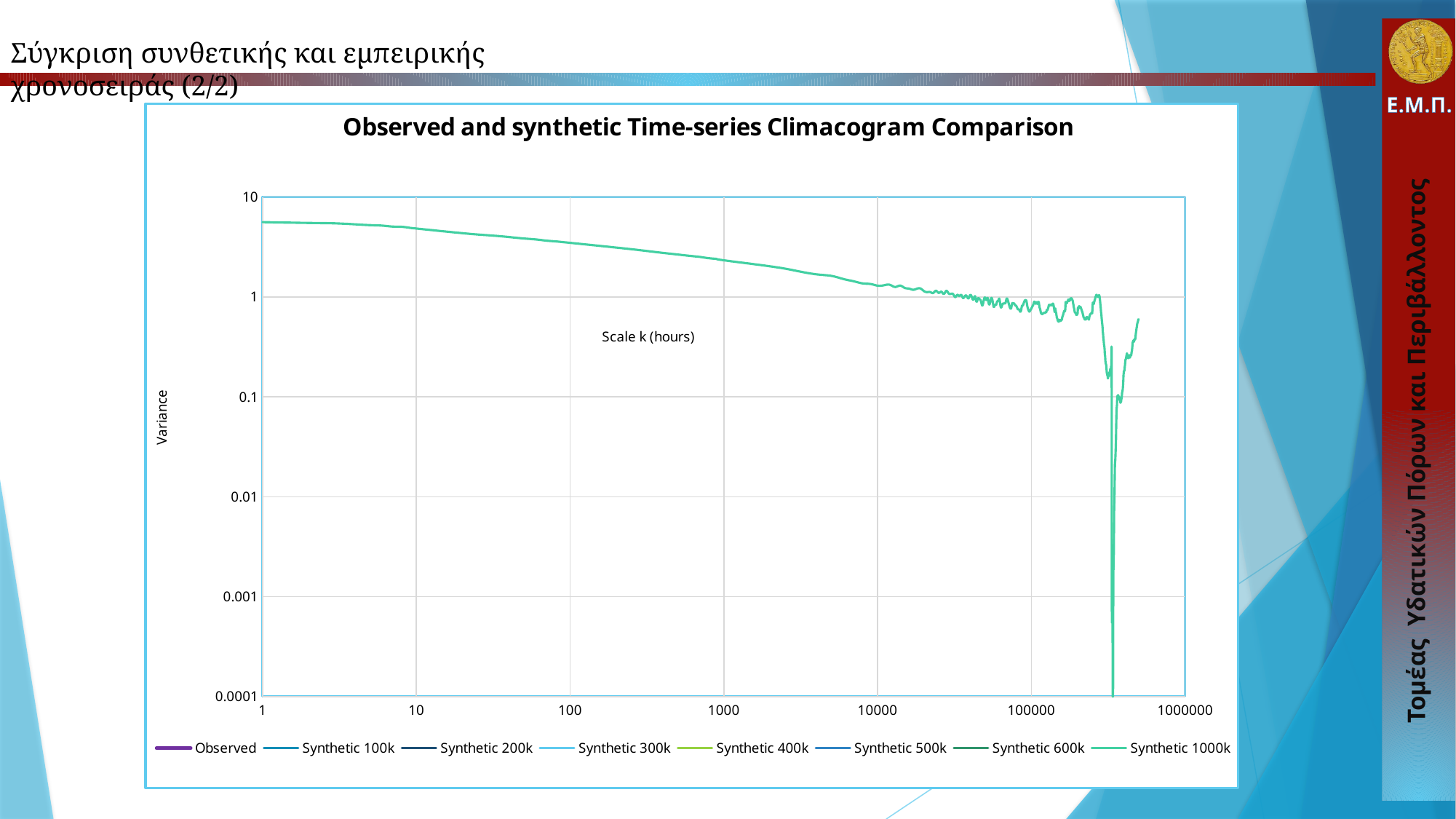
What kind of chart is shown on the slide? line chart Which is larger, the variance at scale k = 1 hour or at scale k = 1000 hours? scale k = 1 hour Is the variance at scale k = 1000 hours greater or less than 1? greater What is the lowest value shown on the vertical axis? 0.0001 What is the highest value shown on the horizontal axis? 1000000 Is the variance at scale k = 1 hour greater or less than 10? less What is the label of the vertical axis? Variance How many series does the chart's legend list? 8 Does the variance generally rise or fall as the scale k increases from 1 to 10000 hours? fall Is the variance at scale k = 100000 hours greater or less than 10? less